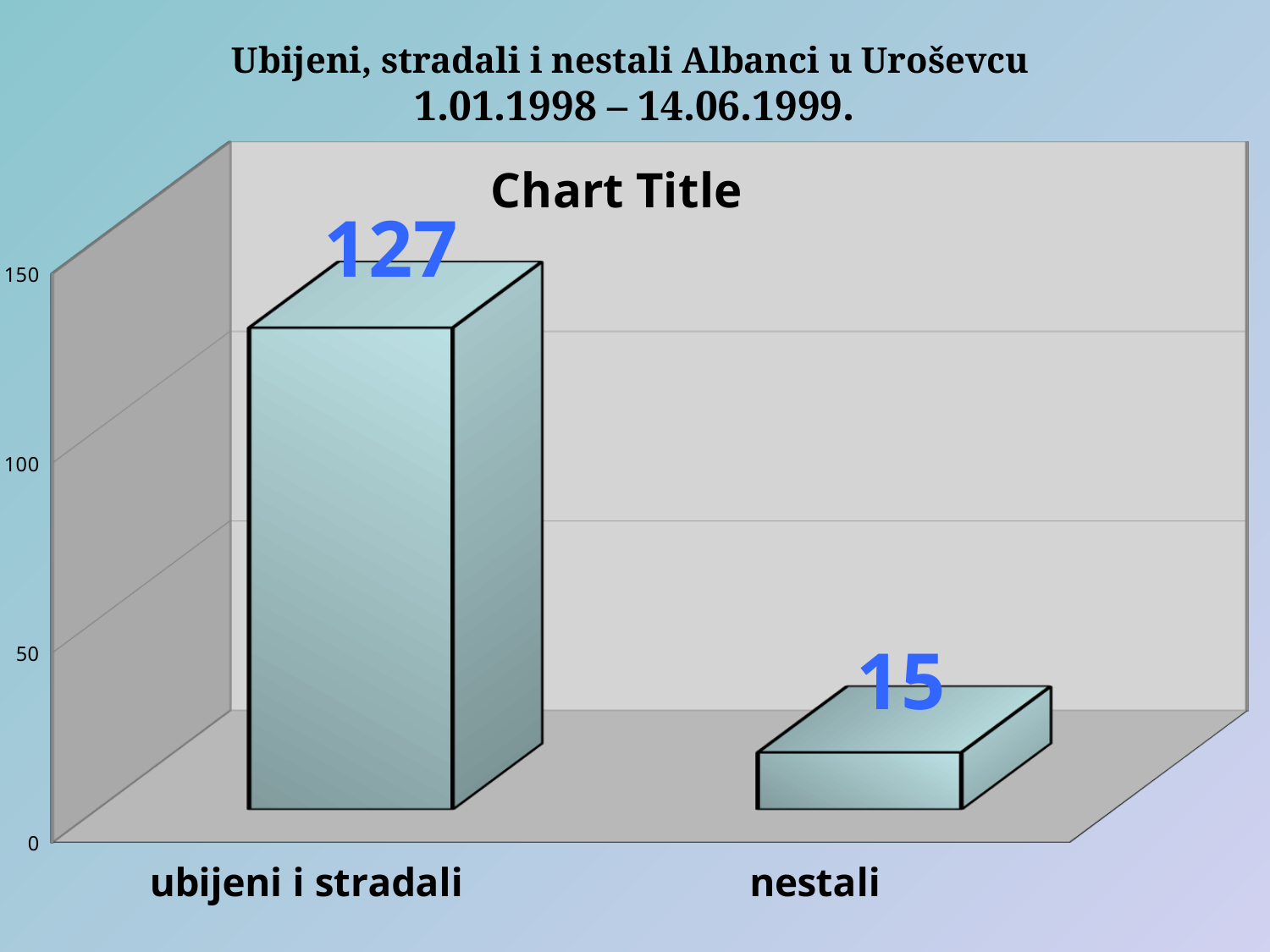
What is the value for "ubijeni i stradali"? 127 How many categories are shown on the chart? 2 What is the difference between the values for "ubijeni i stradali" and "nestali"? 112 Which category has the lowest value? nestali Is the value for "nestali" greater or less than 50? less Is the value for "ubijeni i stradali" greater or less than 100? greater What is the value for "nestali"? 15 What is the title printed inside the chart area? Chart Title Which category has the highest value? ubijeni i stradali Which is larger, the value for "ubijeni i stradali" or the value for "nestali"? ubijeni i stradali What is the total of the two values shown on the chart? 142 What kind of chart is shown on the slide? bar chart